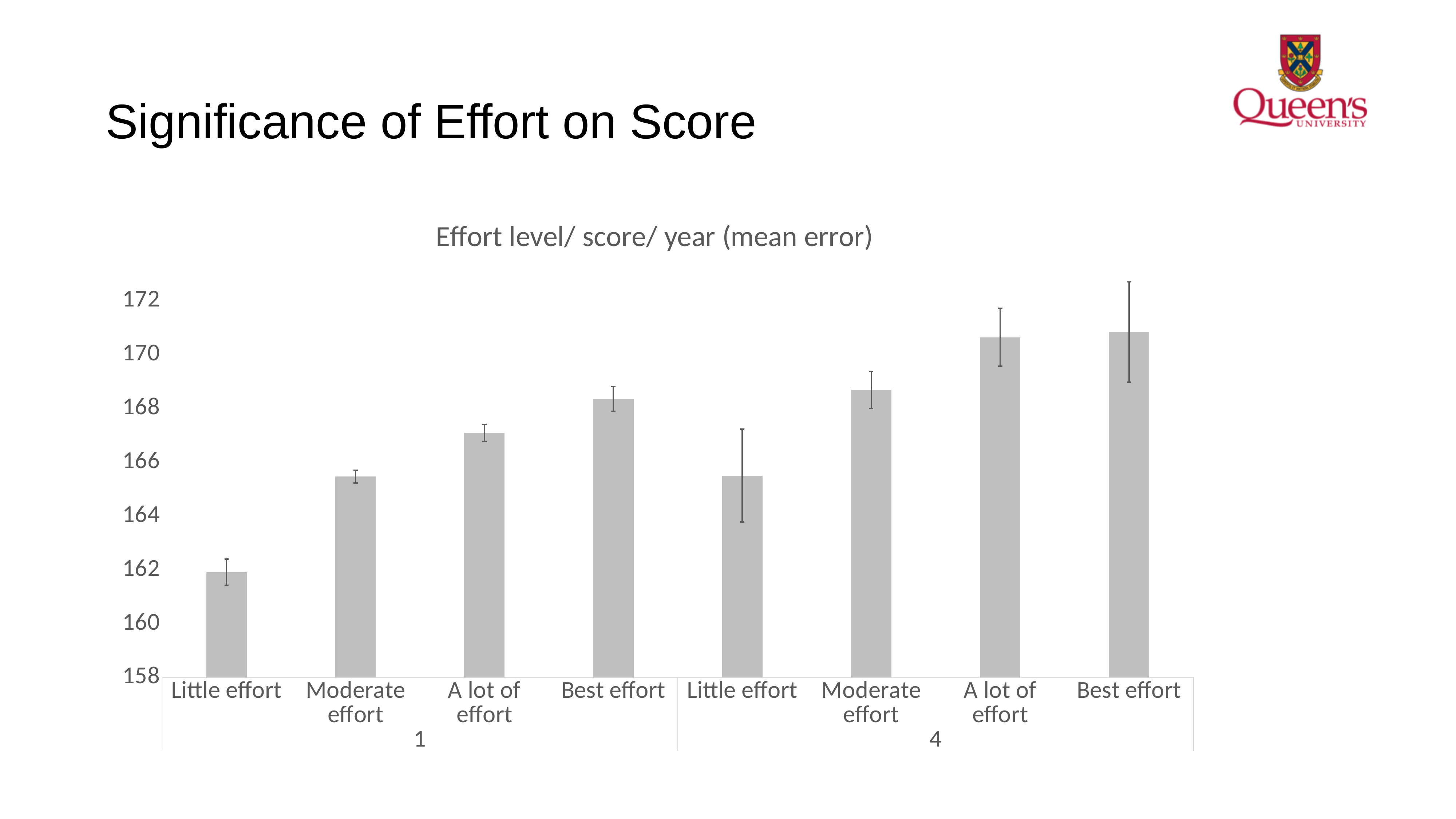
Is the value for Best effort in group 1 greater or less than 170? less Is the value for A lot of effort in group 1 greater or less than 166? greater Is the value for Little effort in group 4 greater or less than 164? greater Within group 1, do the bars rise or fall from Little effort to Best effort? rise What kind of chart is shown on the slide? bar chart Which is larger: Best effort in group 1 or Little effort in group 4? Best effort in group 1 How many bars are plotted in the chart? 8 Which bar is the lowest in the chart? Little effort (year 1) What is the title of the chart? Effort level/ score/ year (mean error)